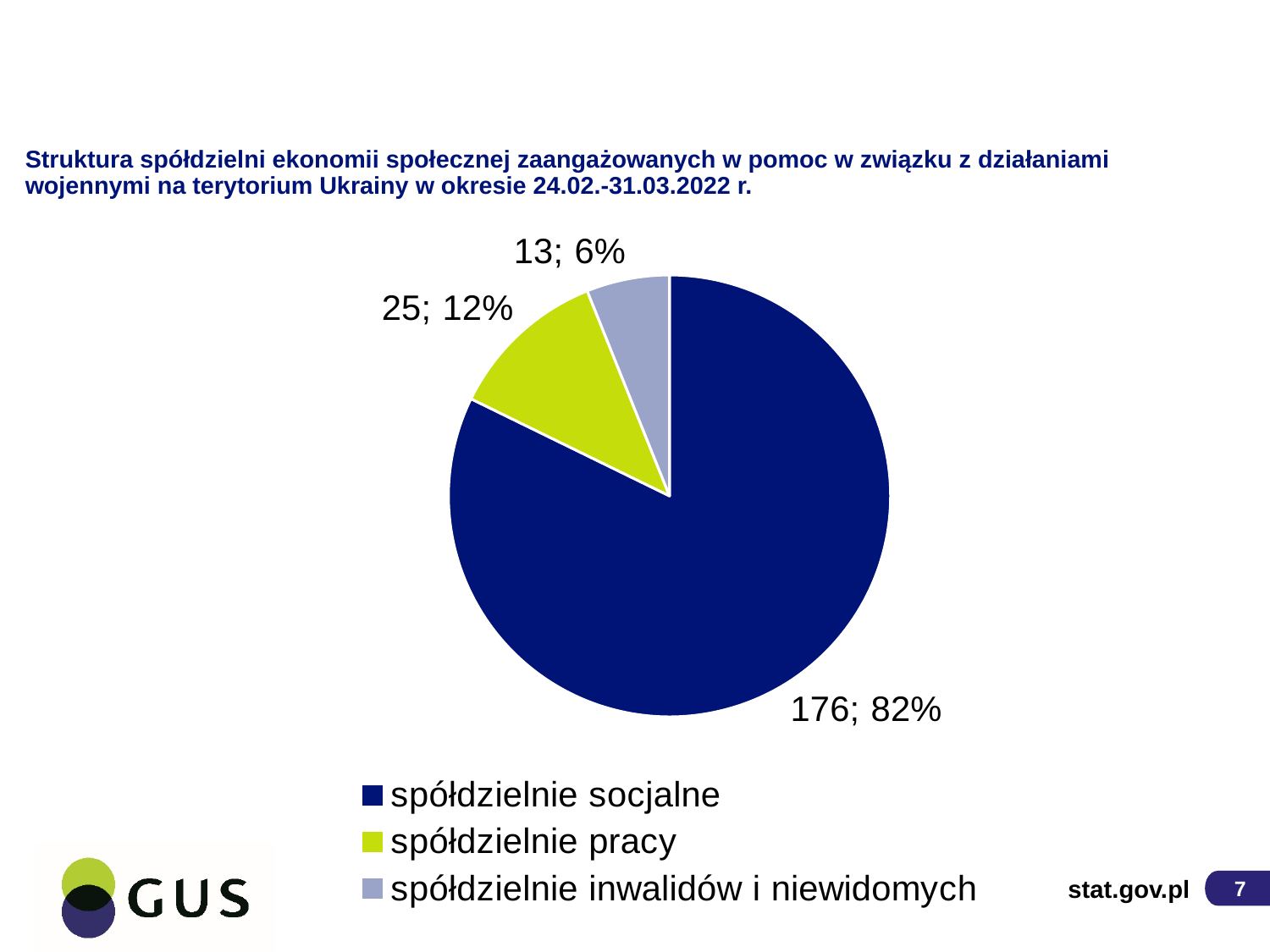
Which category has the largest slice of the pie? spółdzielnie socjalne What share of the pie does spółdzielnie inwalidów i niewidomych represent? 6% What is the value shown for spółdzielnie socjalne? 176 Which colour is used for the spółdzielnie pracy slice? yellow-green How many slices does the pie chart have? 3 What is the difference between the values for spółdzielnie socjalne and spółdzielnie pracy? 151 How many entries does the legend list? 3 What is the value shown for spółdzielnie pracy? 25 What kind of chart is shown on the slide? pie chart What is the value shown for spółdzielnie inwalidów i niewidomych? 13 What share of the pie does spółdzielnie socjalne represent? 82% Which category has the smallest slice of the pie? spółdzielnie inwalidów i niewidomych